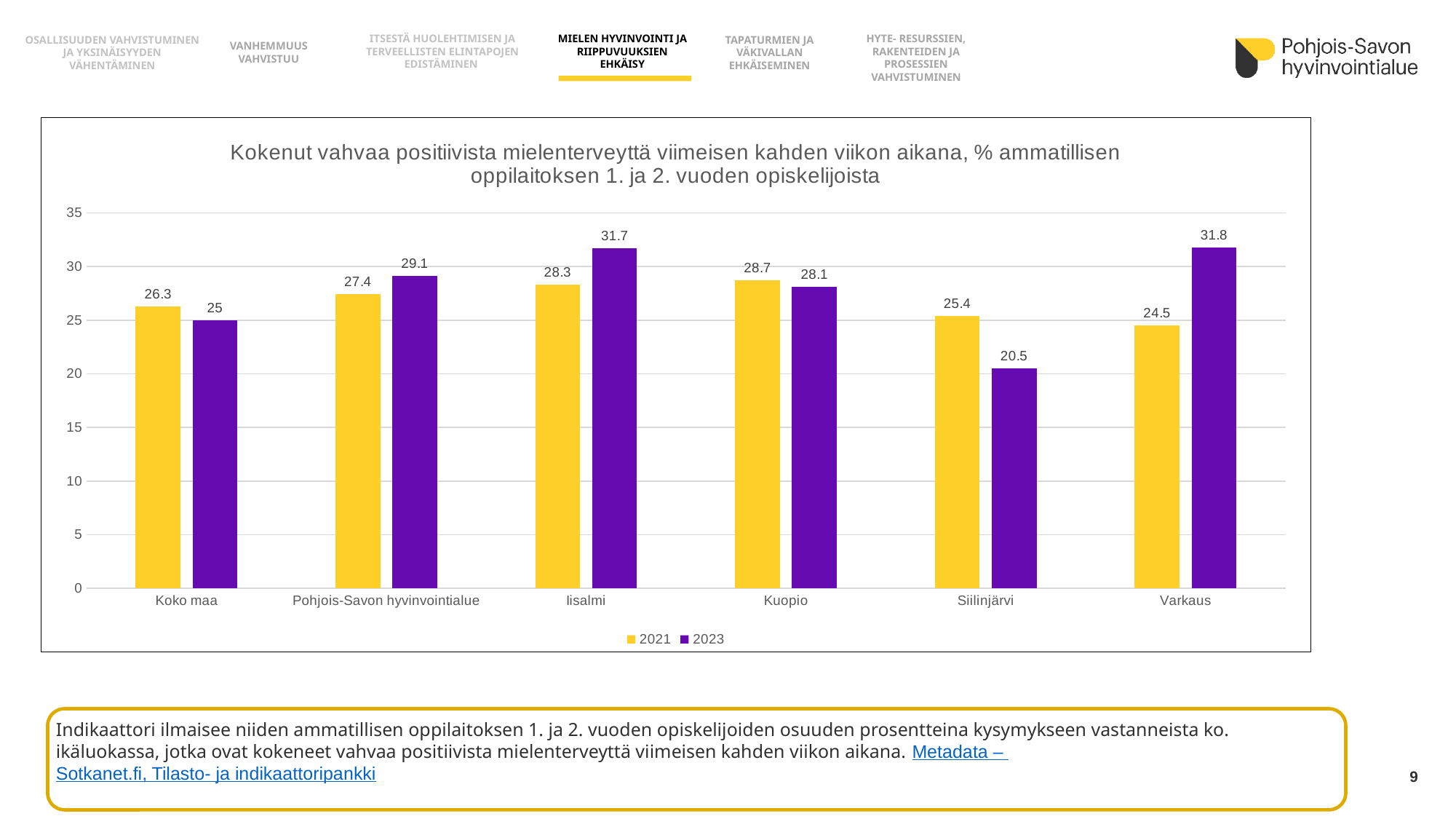
How many series does the legend list? 2 Which category has the lowest 2021 value? Varkaus How many categories are shown on the x axis? 6 Which category has the highest 2023 value? Varkaus Which is larger for Kuopio, the 2021 value or the 2023 value? 2021 What is the 2023 value for Iisalmi? 31.7 What kind of chart is shown on the slide? Bar chart What is the 2023 value for Koko maa? 25 What is the 2021 value for Siilinjärvi? 25.4 What is the difference between the 2021 and 2023 values for Siilinjärvi? 4.9 Which category has the lowest 2023 value? Siilinjärvi What is the difference between the 2023 and 2021 values for Varkaus? 7.3